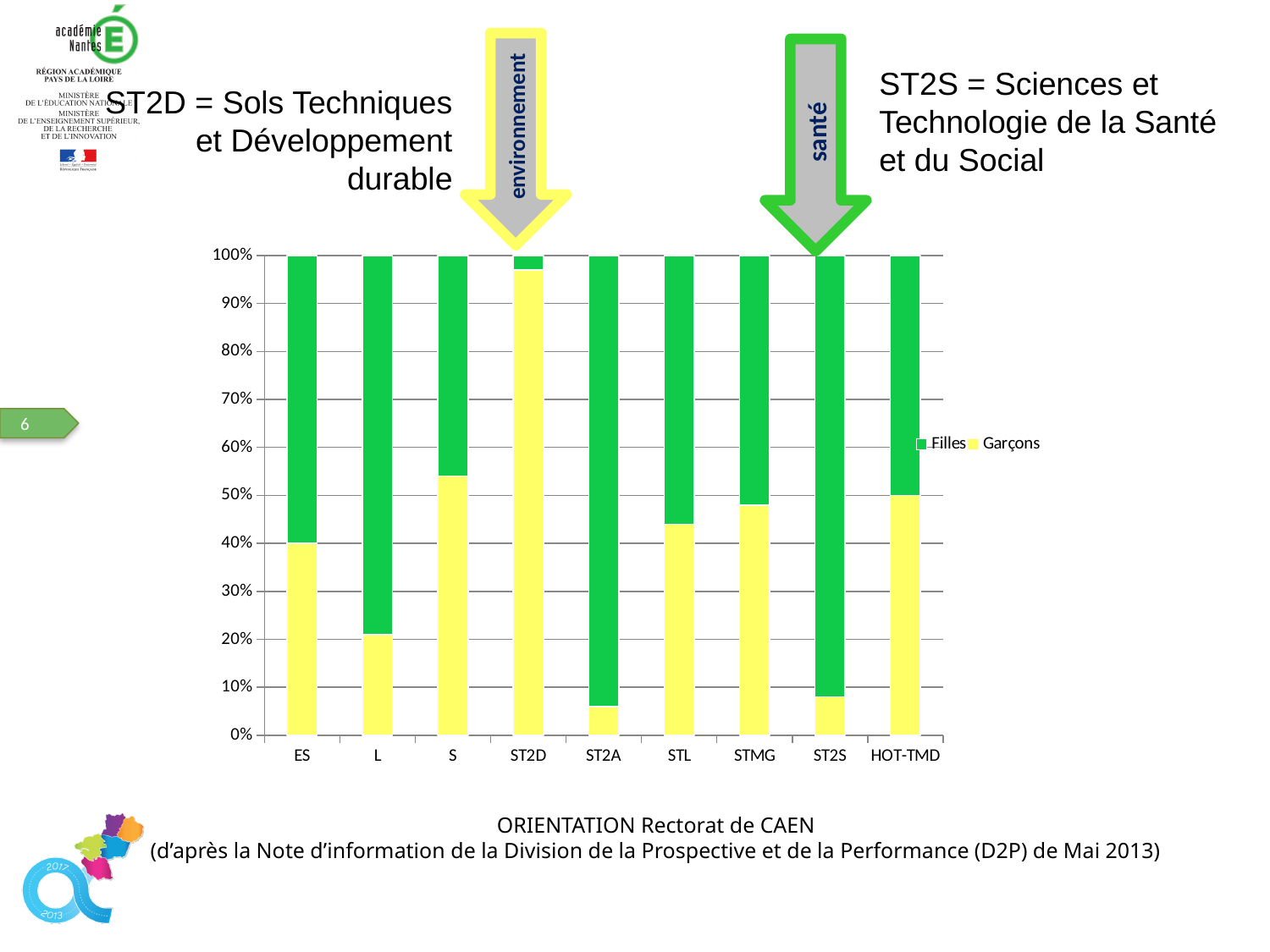
Which colour represents the Filles series in the chart? green How many categories are shown on the x axis of the chart? 9 Is the share of Garçons for ST2D greater or less than 90%? greater Which series are listed in the chart legend? Filles and Garçons Is the share of Garçons for ST2S greater or less than 10%? less Is the share of Garçons for L greater or less than 30%? less Which category has the highest share of Filles? ST2A How many series does the chart legend list? 2 What kind of chart is shown on the slide? stacked bar chart Which category has a larger share of Garçons, S or STL? S Which category has the lowest share of Garçons? ST2A Which category has the highest share of Garçons? ST2D